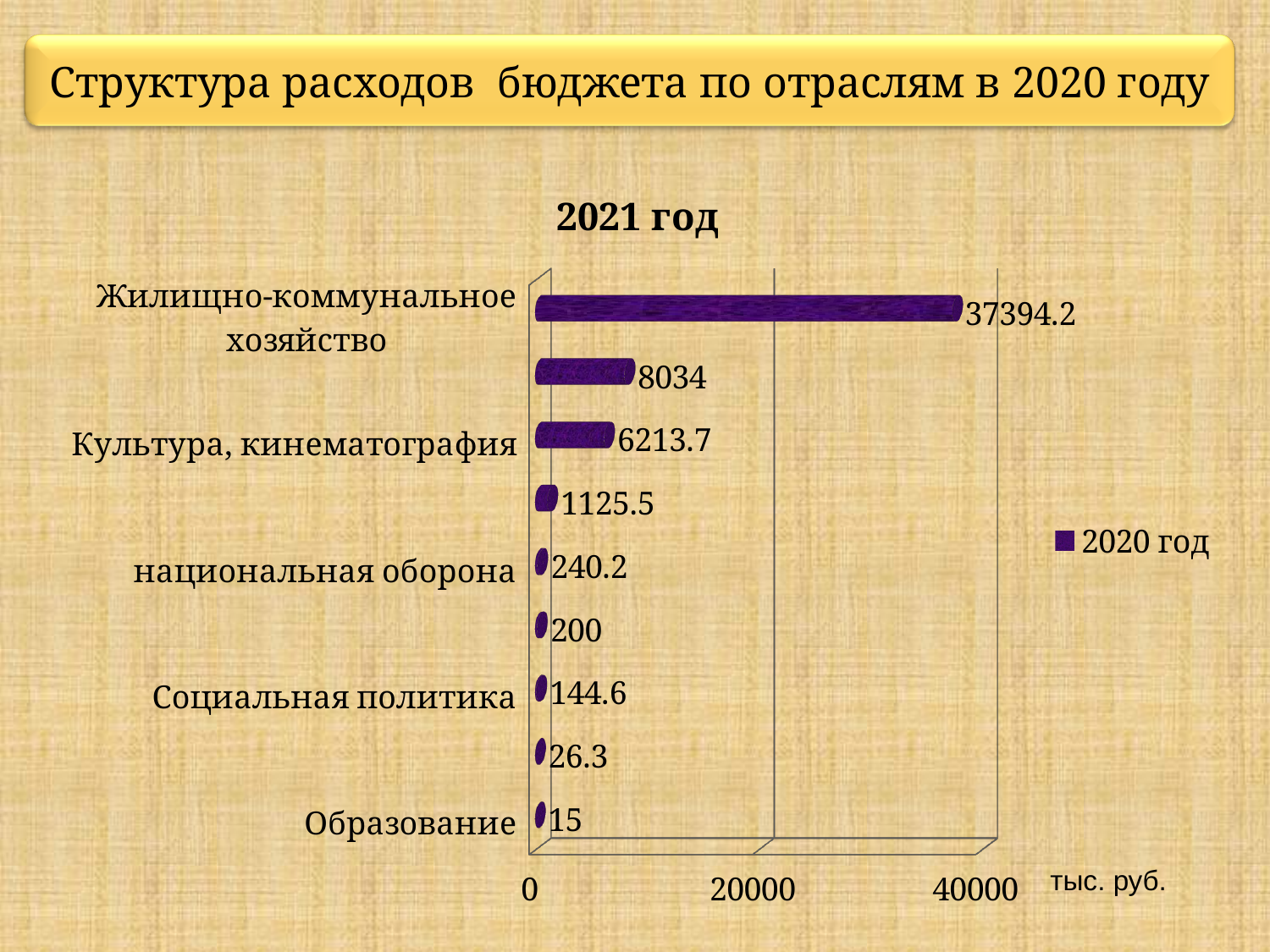
What type of chart is shown on the slide? bar chart What is the title shown above the chart? 2021 год Which category has the highest value? Жилищно-коммунальное хозяйство How many bars are plotted in the chart? 9 What is the value for национальная оборона? 240.2 What is the value for Культура, кинематография? 6213.7 Which is larger, the value for национальная оборона or the value for Социальная политика? национальная оборона What is the difference between the values for Жилищно-коммунальное хозяйство and Культура, кинематография? 31180.5 What is the value for Образование? 15 Which category has the lowest value? Образование What is the value for Жилищно-коммунальное хозяйство? 37394.2 What is the value for Социальная политика? 144.6